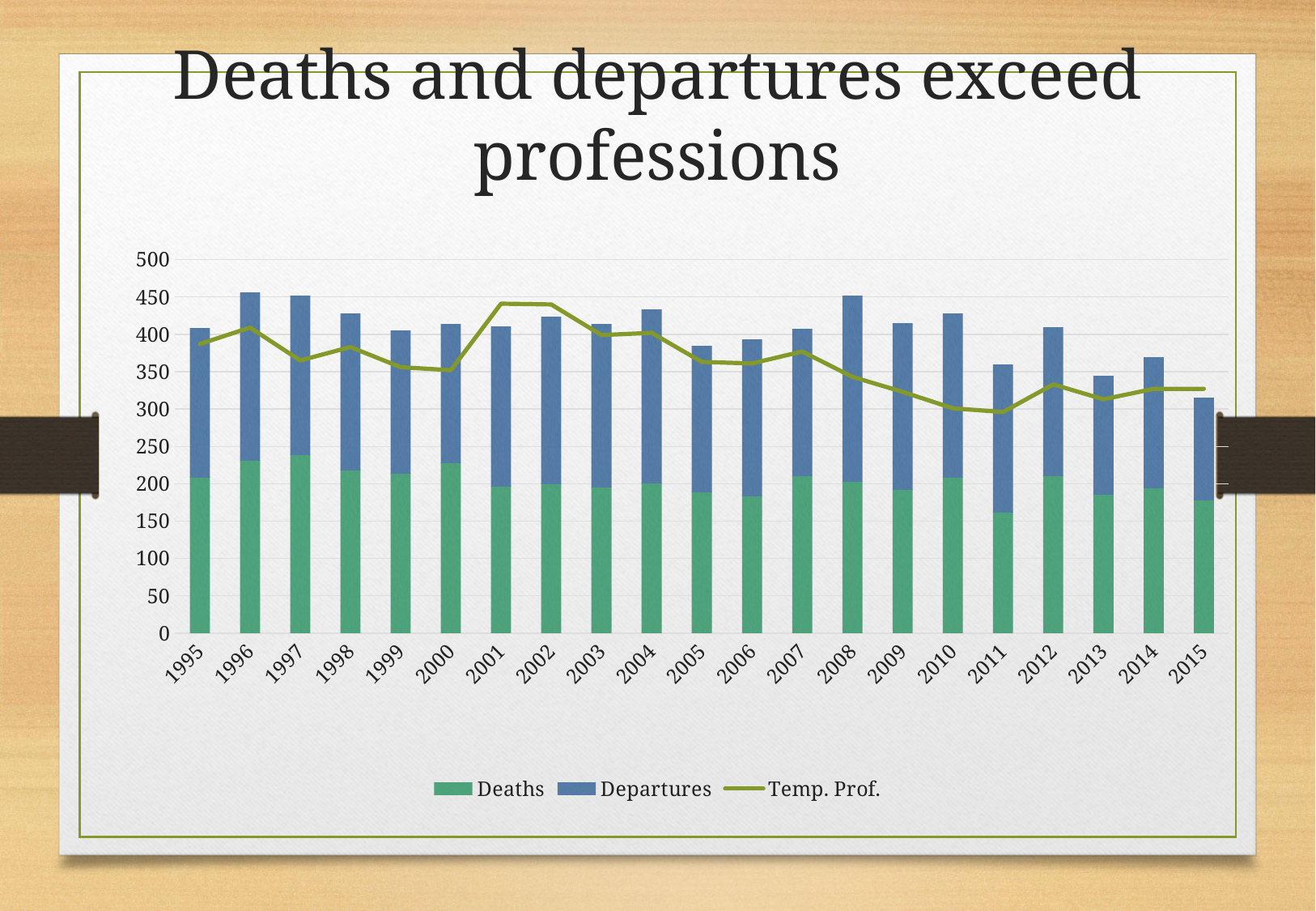
How many series does the chart legend list? 3 Is the Deaths value for 2011 greater or less than 200? less Is the total stacked bar for 1996 greater or less than 400? greater Is the Temp. Prof. value for 2001 greater or less than 400? greater Which series is drawn as a line rather than bars? Temp. Prof. Which year has the larger total stacked bar, 1996 or 2015? 1996 How many years are shown on the x axis of the chart? 21 What kind of chart is shown on the slide? Stacked bar chart with a line Which year has the lowest total stacked bar (Deaths plus Departures)? 2015 What is the title of the slide? Deaths and departures exceed professions Does the Temp. Prof. line overall rise or fall from 1995 to 2015? fall